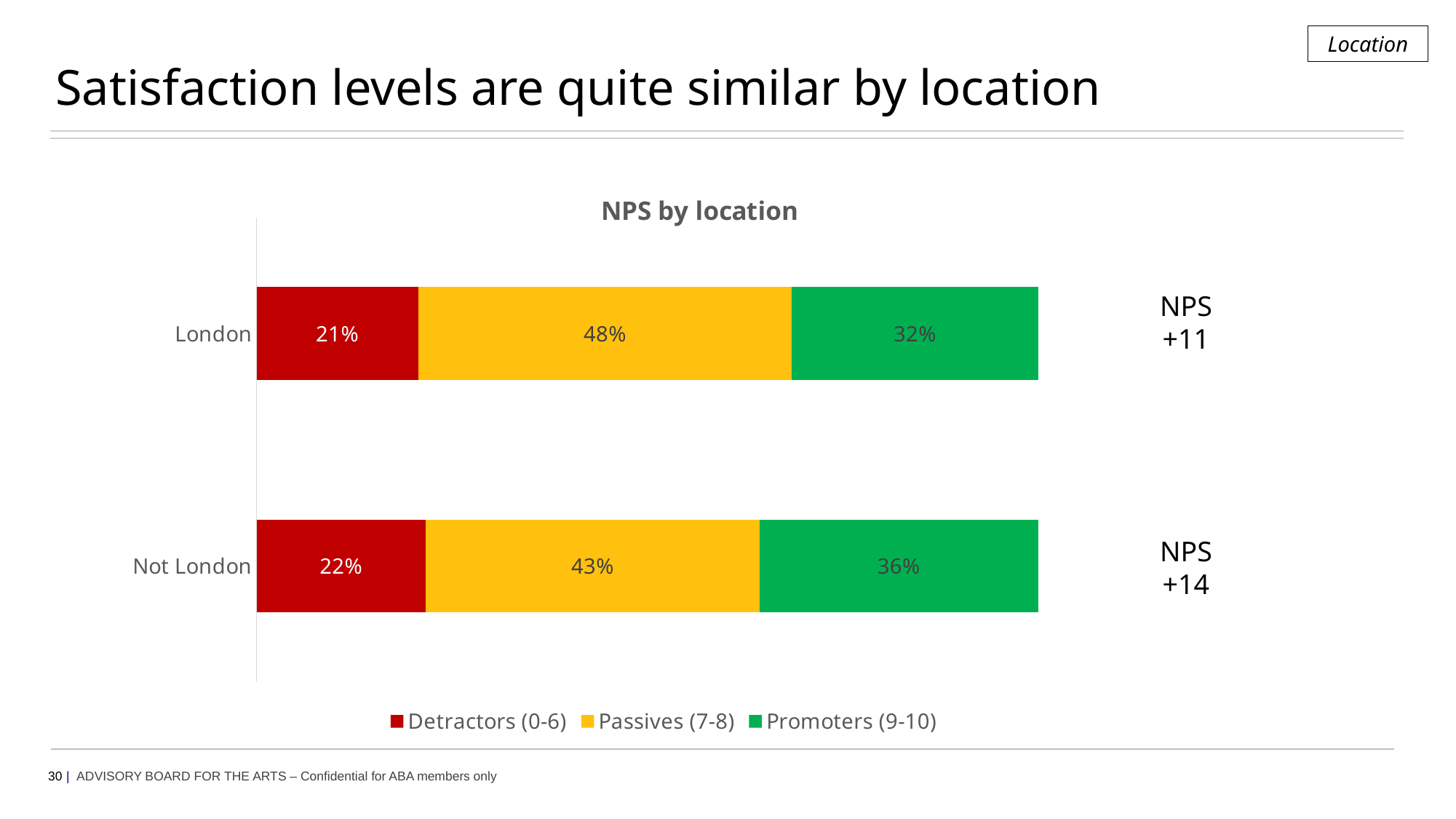
What percentage of Not London respondents are Promoters (9-10)? 36% What is the difference in the Passives (7-8) share between London and Not London? 5 percentage points Which location has the higher share of Promoters (9-10)? Not London What percentage of London respondents are Passives (7-8)? 48% What kind of chart is shown on the slide? Stacked bar chart How many locations are shown on the chart? 2 What is the difference in the Promoters (9-10) share between Not London and London? 4 percentage points What is the NPS shown for Not London? +14 Which location has the higher share of Passives (7-8)? London What percentage of London respondents are Detractors (0-6)? 21% How many series does the legend list? 3 What is the title of the chart? NPS by location